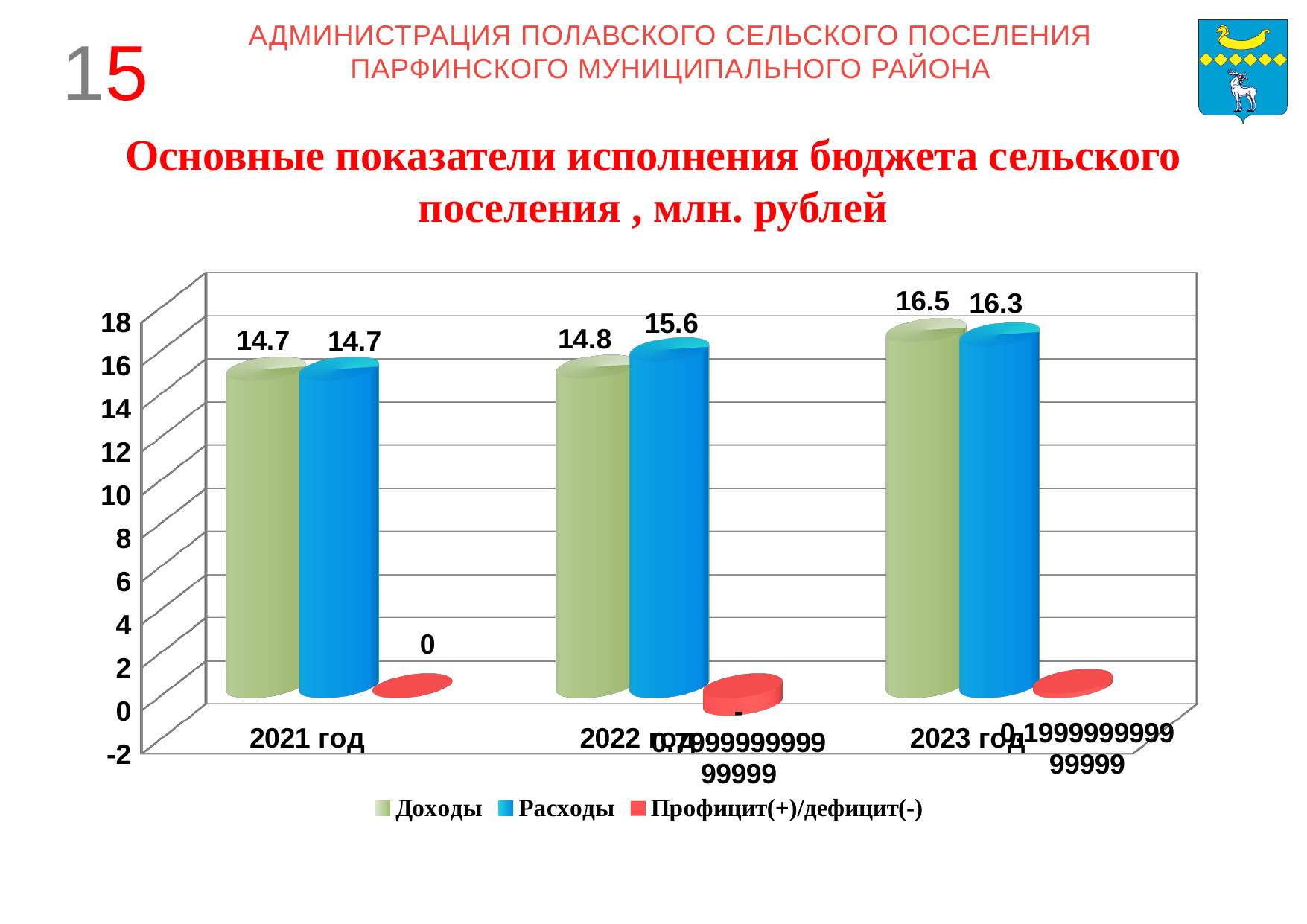
In which year is Доходы the highest? 2023 год What is the difference between Расходы and Доходы in 2022 год? 0.8 In which year is Расходы the lowest? 2021 год What is the value of Доходы for 2023 год? 16.5 How many years are shown on the x axis? 3 Which is larger in 2023 год, Доходы or Расходы? Доходы How many series does the legend list? 3 What kind of chart is shown on the slide? bar chart What is the value of Профицит(+)/дефицит(-) for 2021 год? 0 What is the value of Расходы for 2023 год? 16.3 What is the value of Расходы for 2022 год? 15.6 What is the value of Доходы for 2021 год? 14.7